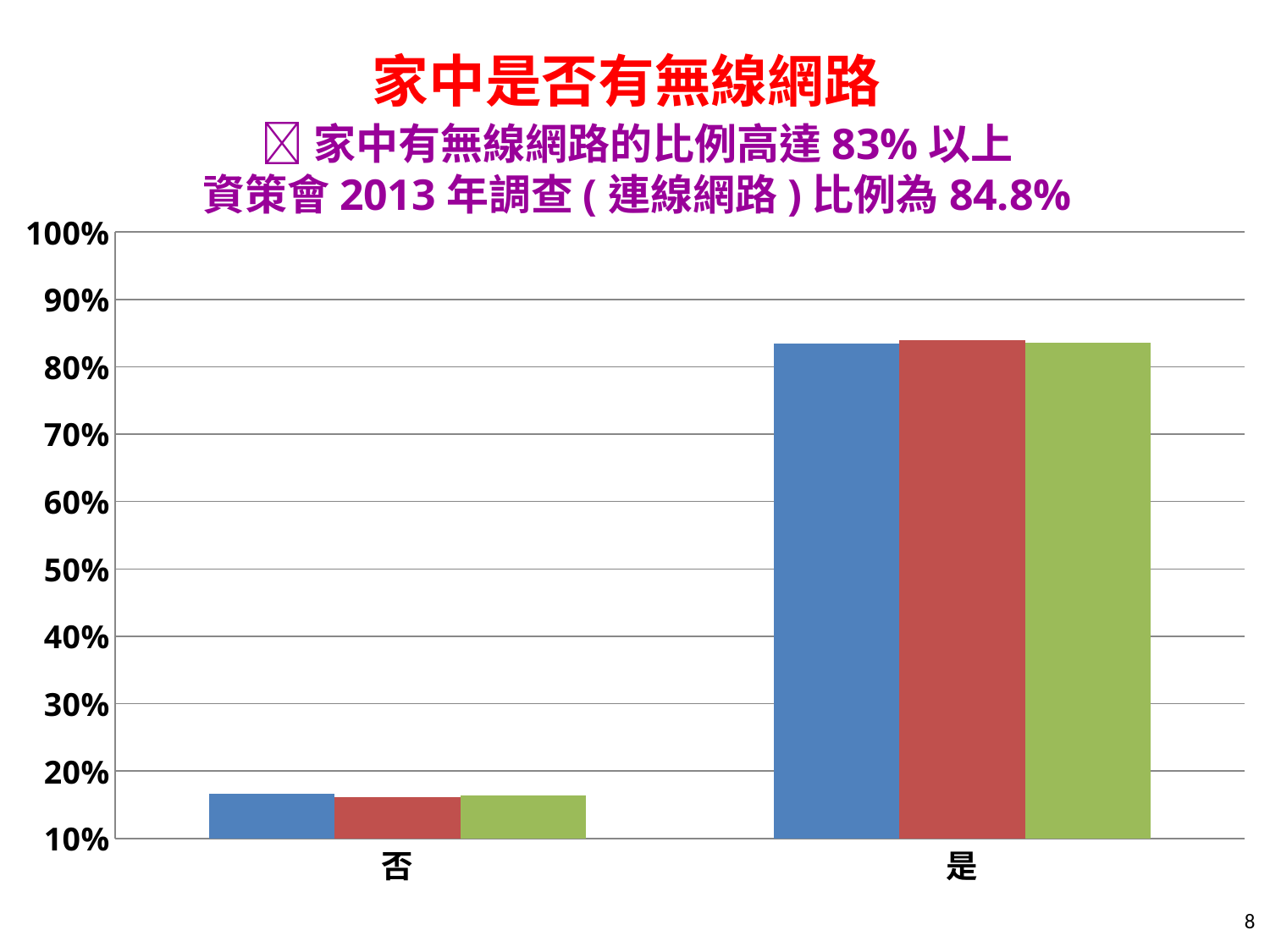
How many bars are plotted for the category 是? 3 Do the bar values rise or fall from 否 to 是 along the x axis? rise What is the title of the chart on the slide? 家中是否有無線網路 Is the value of the blue bar for 否 greater or less than 20%? less Is the value of the green bar for 否 greater or less than 30%? less Which is larger, the blue bar for 否 or the blue bar for 是? the blue bar for 是 Is the value of the red bar for 是 greater or less than 90%? less Which category has the highest bars, 否 or 是? 是 How many categories are shown on the x axis of the chart? 2 What kind of chart is shown on the slide? bar chart Which category has the lowest bars, 否 or 是? 否